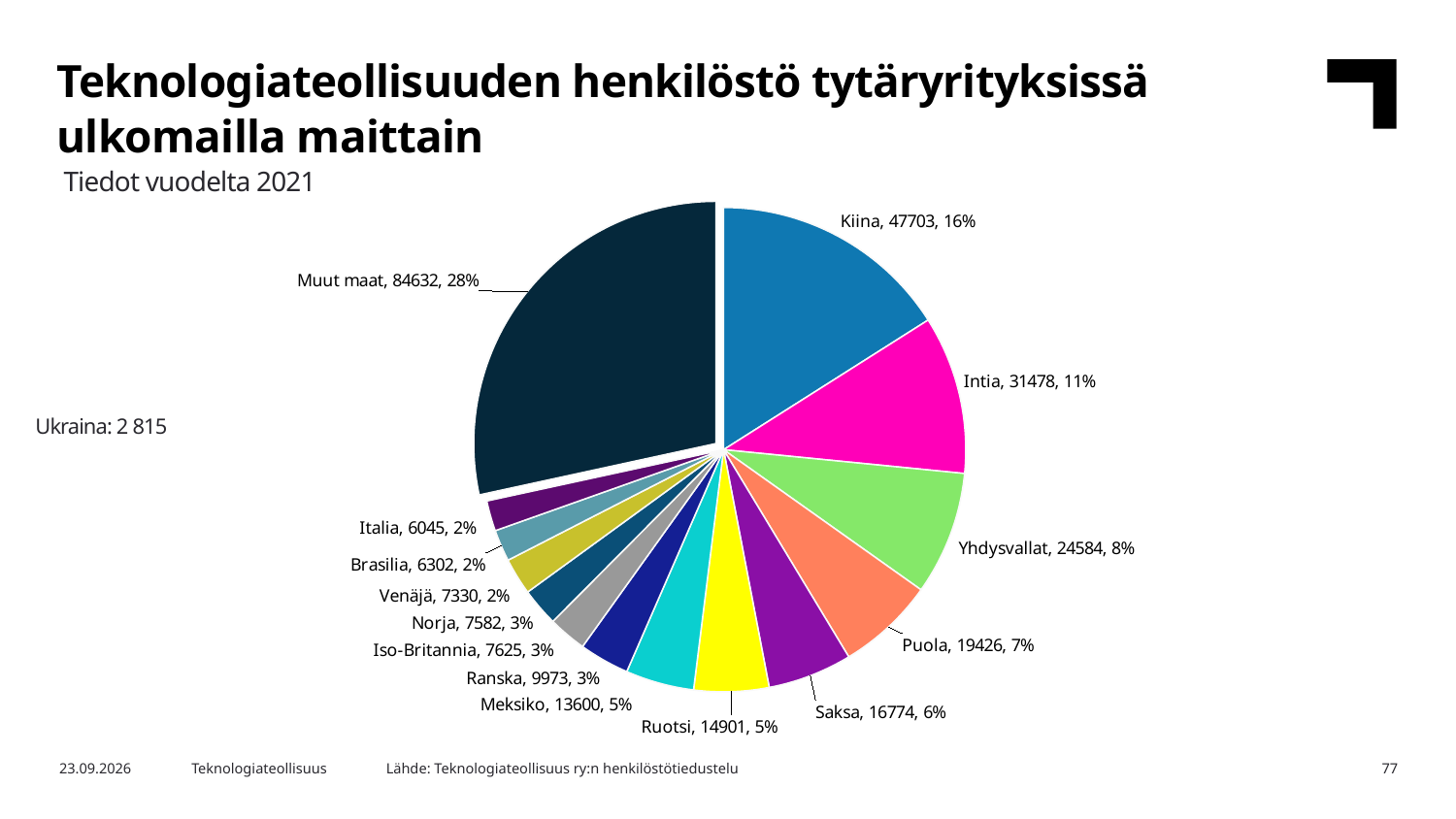
What is the value shown for Kiina? 47703 Which slice of the pie chart is the smallest? Italia How many slices does the pie chart have? 14 Which has a larger value, Puola or Saksa? Puola Which slice of the pie chart is the largest? Muut maat What type of chart is shown on the slide? Pie chart What is the value shown for Yhdysvallat? 24584 What percentage share does Muut maat have in the pie chart? 28% What is the value shown for Ruotsi? 14901 What is the difference between the values for Kiina and Intia? 16225 What percentage share does Intia have in the pie chart? 11% What year do the data on the slide come from, according to the subtitle? 2021